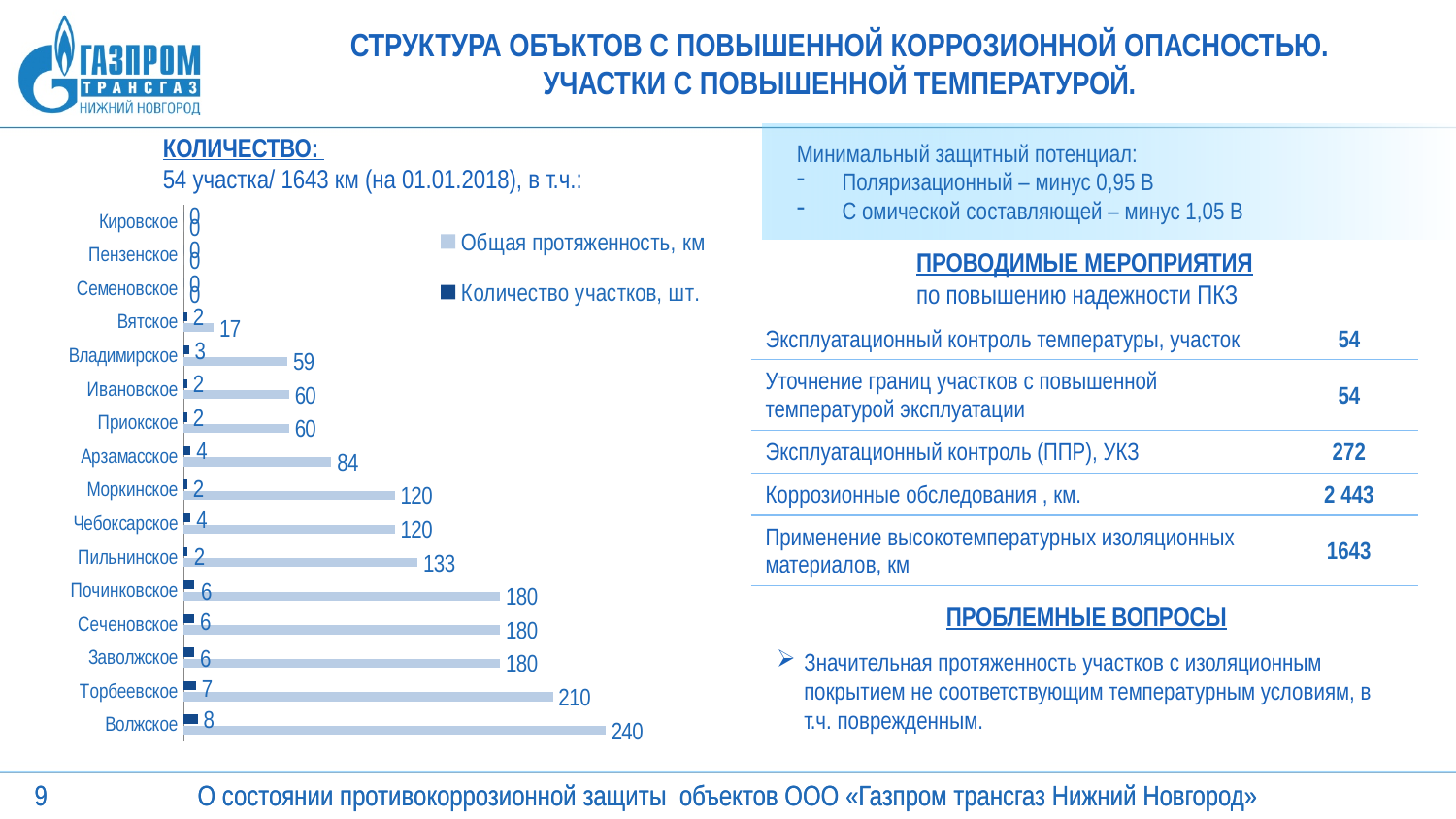
What is the difference in "Количество участков, шт." between Волжское and Вятское? 6 Which has a larger "Общая протяженность, км" value, Арзамасское or Моркинское? Моркинское What is the value of "Общая протяженность, км" for Волжское? 240 What is the value of "Общая протяженность, км" for Пильнинское? 133 How many series does the chart legend list? 2 Which series in the legend is shown in light blue? Общая протяженность, км What is the value of "Количество участков, шт." for Торбеевское? 7 What kind of chart is shown on the slide? bar chart Which category has the lowest non-zero value of "Общая протяженность, км"? Вятское How many categories (branches) are shown on the chart's vertical axis? 16 What is the difference in "Общая протяженность, км" between Волжское and Торбеевское? 30 Which category has the highest value of "Общая протяженность, км"? Волжское